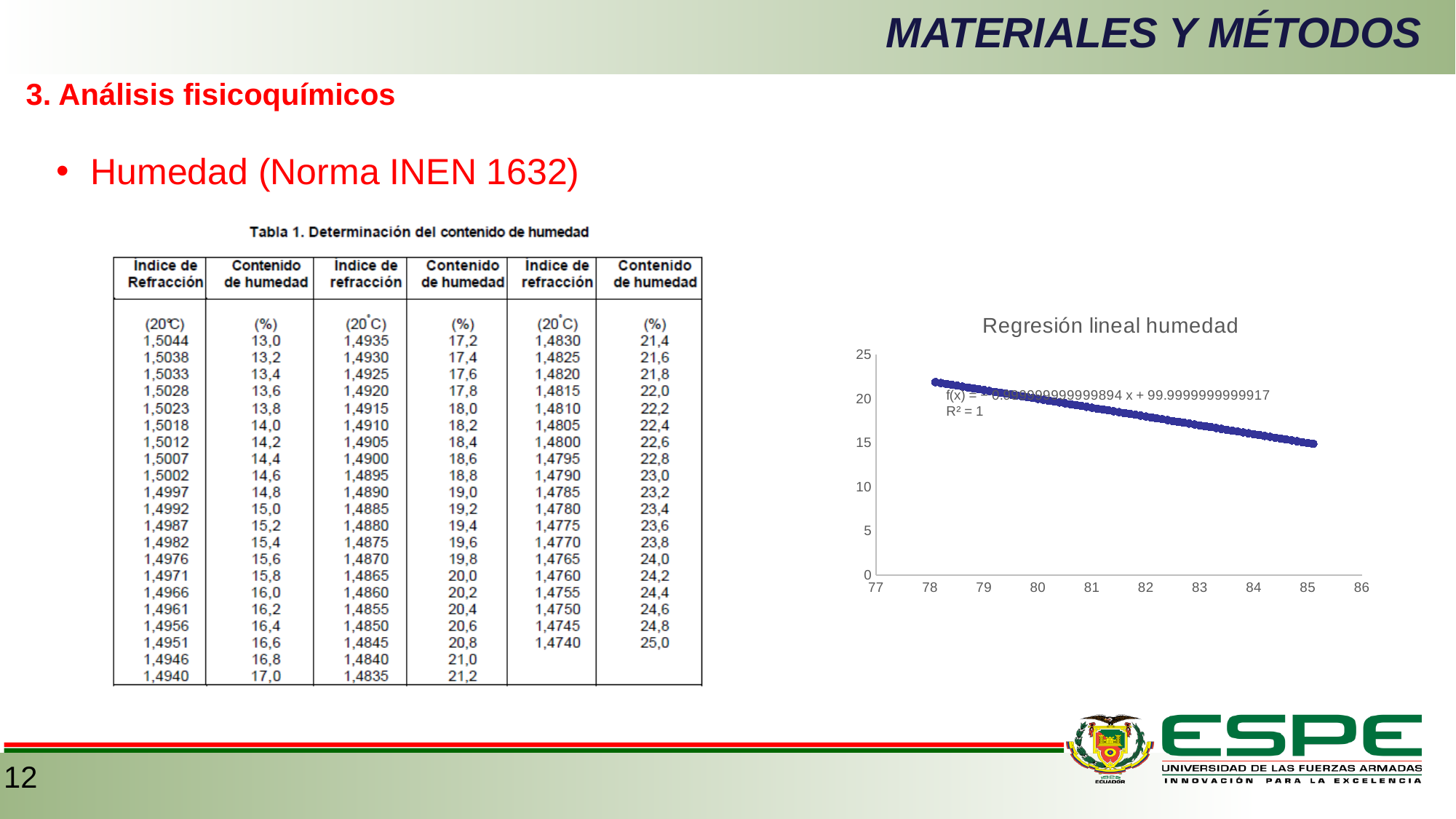
In the 'Regresión lineal humedad' chart, is the plotted value near x = 85 greater or less than 10? greater What is the title of the chart on the right side of the slide? Regresión lineal humedad What R² value is printed on the 'Regresión lineal humedad' chart? R² = 1 What is the lowest value labelled on the x-axis of the 'Regresión lineal humedad' chart? 77 In the 'Regresión lineal humedad' chart, is the plotted value at the right end of the series (near x = 85) greater or less than 20? less In the 'Regresión lineal humedad' chart, is the plotted value near x = 78 greater or less than 25? less What kind of chart is 'Regresión lineal humedad'? scatter chart In the 'Regresión lineal humedad' chart, do the plotted values rise or fall as the x-axis value increases? fall In the 'Regresión lineal humedad' chart, which end of the series has the higher plotted value: the point near x = 78 or the point near x = 85? the point near x = 78